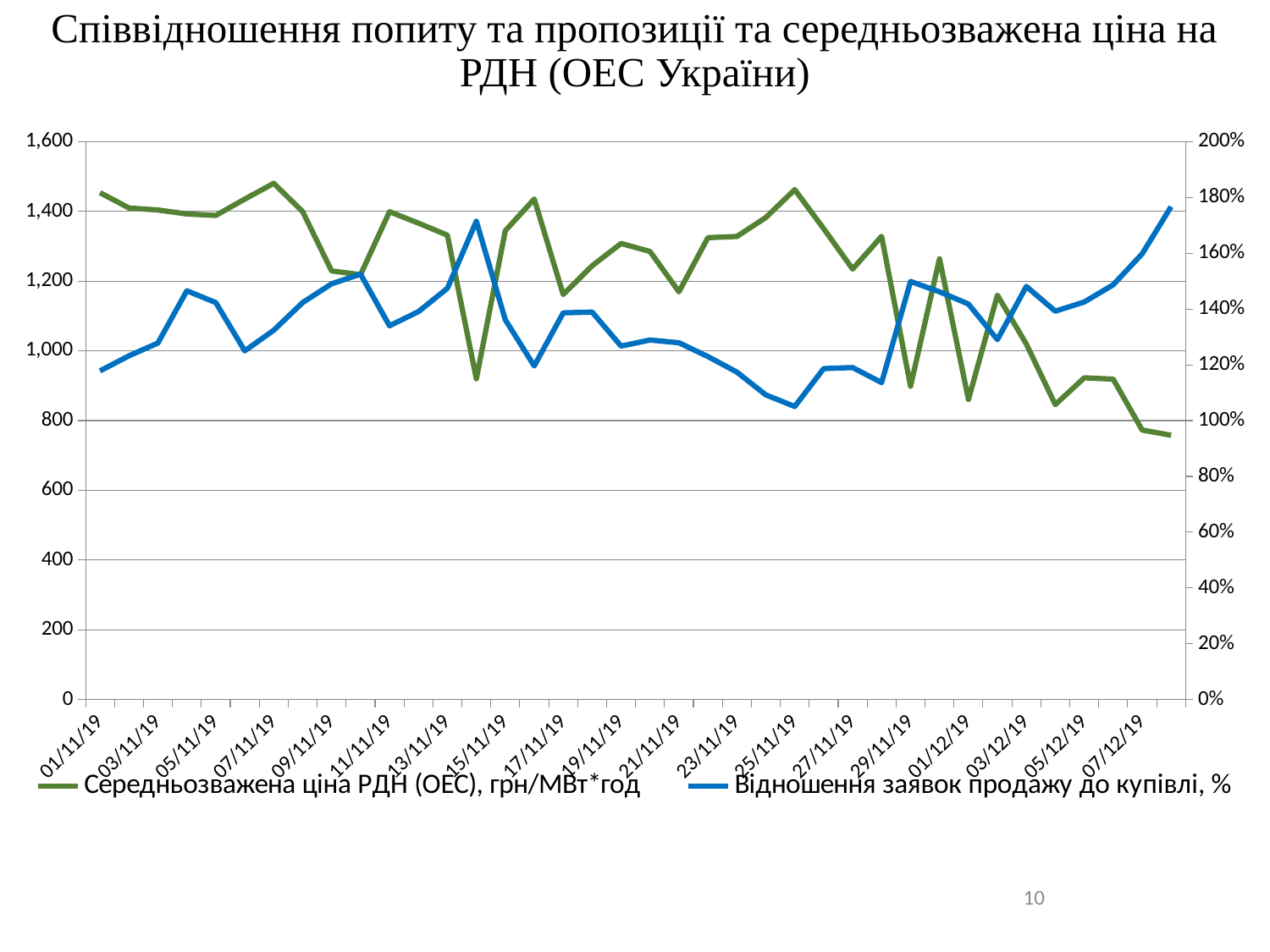
Is the value of Середньозважена ціна РДН (ОЕС) on 01/11/19 greater or less than 1,400? greater On which date does Відношення заявок продажу до купівлі reach its lowest value? 25/11/19 Is the value of Середньозважена ціна РДН (ОЕС) on 07/12/19 greater or less than 800? less Is the value of Відношення заявок продажу до купівлі on 25/11/19 greater or less than 120%? less Which is larger for Середньозважена ціна РДН (ОЕС): the value on 01/11/19 or on 07/12/19? 01/11/19 Which series is drawn in green? Середньозважена ціна РДН (ОЕС), грн/МВт*год From the first date to the last date, does Середньозважена ціна РДН (ОЕС) overall rise or fall? fall How many series does the legend list? 2 What is the highest value shown on the right-hand vertical axis? 200% What kind of chart is shown on the slide? line chart